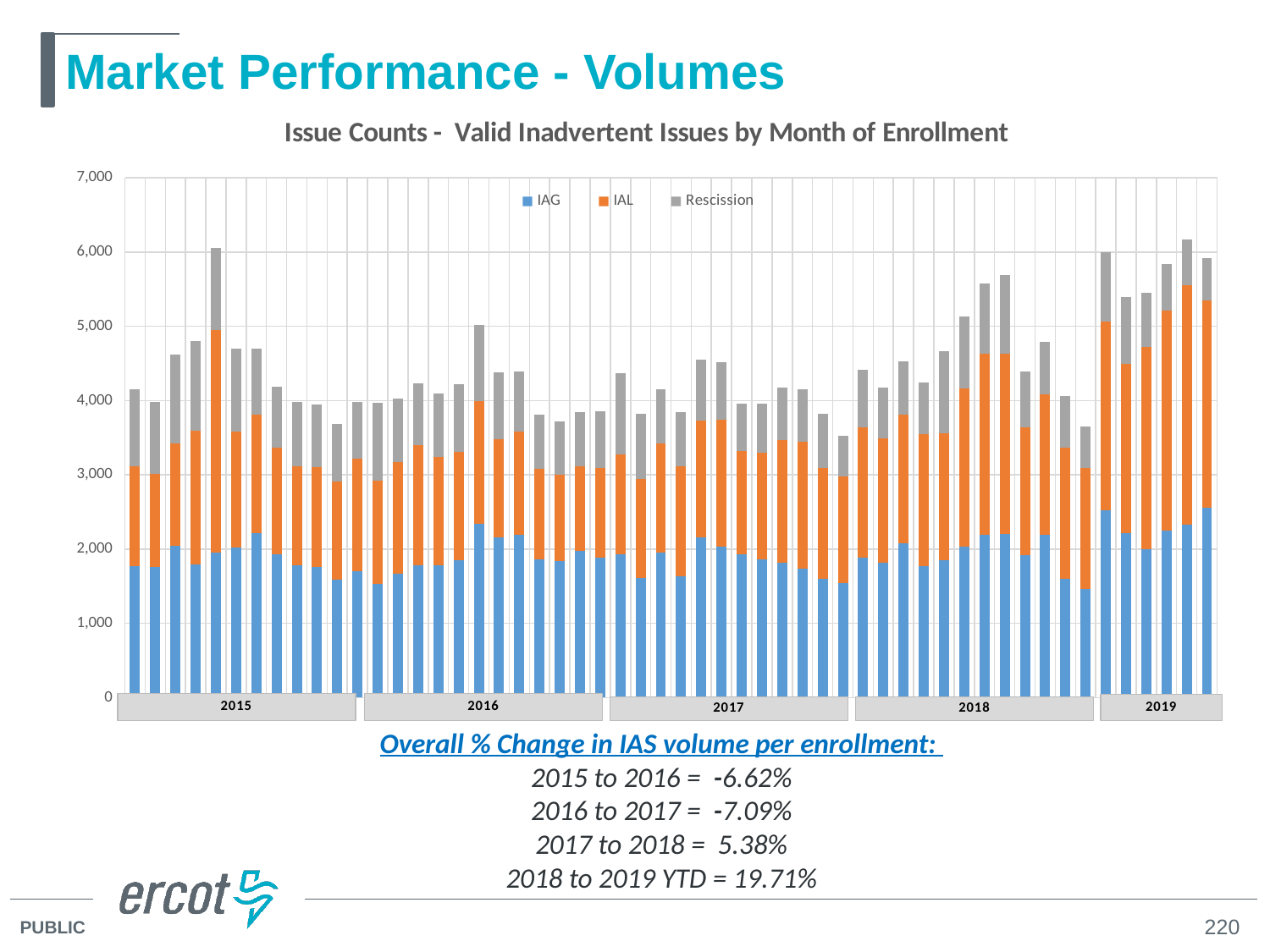
Does any bar on the chart reach the 7,000 gridline? No Is the tallest bar in the 2019 group greater or less than 5,000? greater What kind of chart is shown on the slide? Stacked bar chart How many monthly bars are plotted in the 2019 group? 6 How many series does the chart legend list? 3 Is the shortest bar in the 2017 group greater or less than 4,000? less How many monthly bars are plotted in the 2015 group? 12 How many year groups are labelled along the x axis of the chart? 5 Is the tallest bar in the 2019 group taller or shorter than the tallest bar in the 2017 group? taller What is the title of the chart? Issue Counts - Valid Inadvertent Issues by Month of Enrollment What are the three series named in the chart legend? IAG, IAL, Rescission